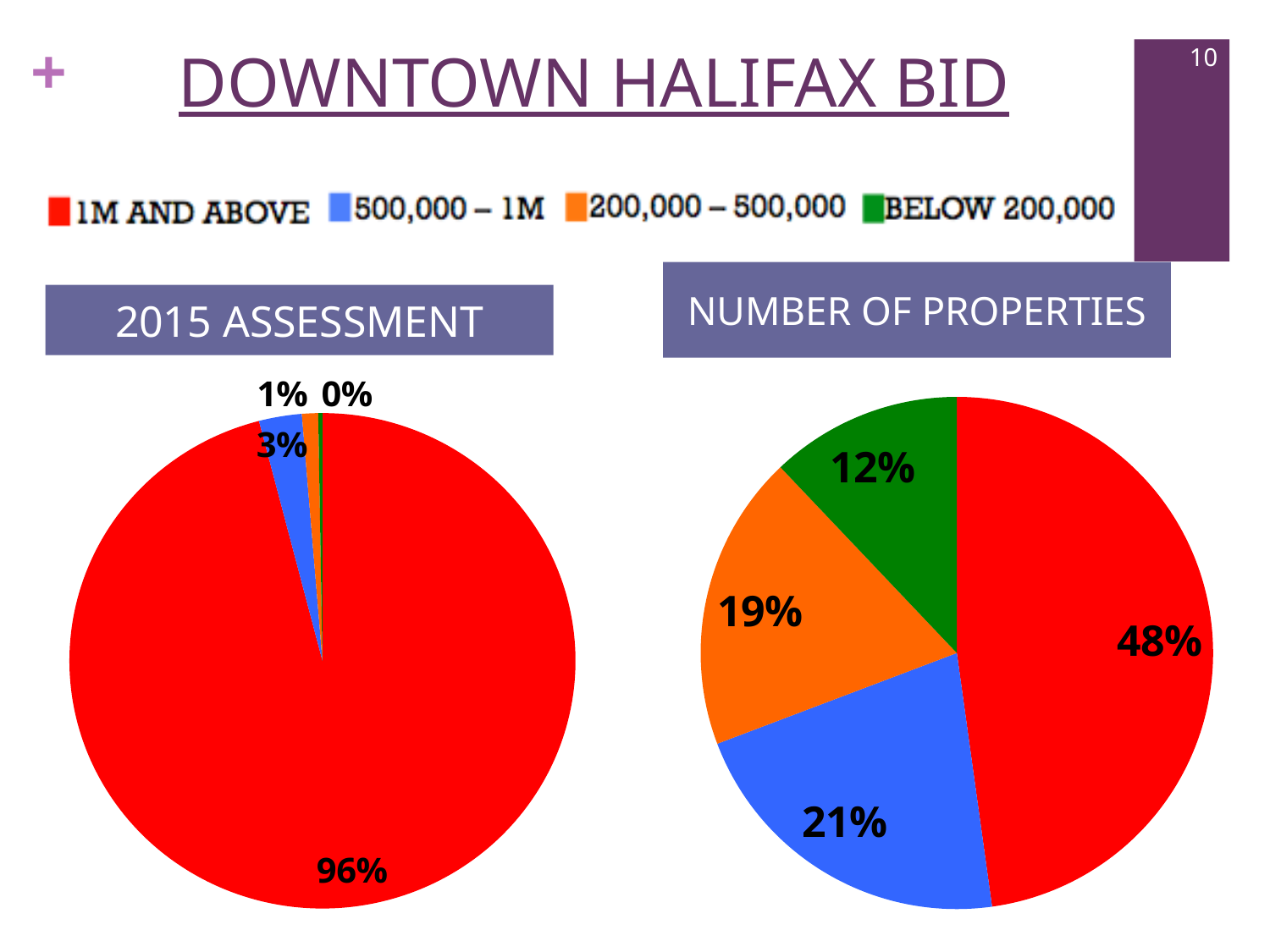
In the NUMBER OF PROPERTIES chart, which is larger: the 200,000 – 500,000 share or the BELOW 200,000 share? 200,000 – 500,000 In the 2015 ASSESSMENT chart, what is the value for the 200,000 – 500,000 category? 1% In the 2015 ASSESSMENT chart, which category has the smallest share? BELOW 200,000 In the NUMBER OF PROPERTIES chart, what is the difference between the 1M AND ABOVE share and the 500,000 – 1M share? 27% In the NUMBER OF PROPERTIES chart, what is the value for the 500,000 – 1M category? 21% In the NUMBER OF PROPERTIES chart, which category has the smallest share? BELOW 200,000 How many categories does the legend list? 4 In the NUMBER OF PROPERTIES chart, which category has the largest share? 1M AND ABOVE In the NUMBER OF PROPERTIES chart, what share does the BELOW 200,000 category have? 12% In the 2015 ASSESSMENT chart, what share does the 1M AND ABOVE category have? 96% What kind of chart is the 2015 ASSESSMENT chart? Pie chart Which colour represents the 500,000 – 1M category in the legend? Blue